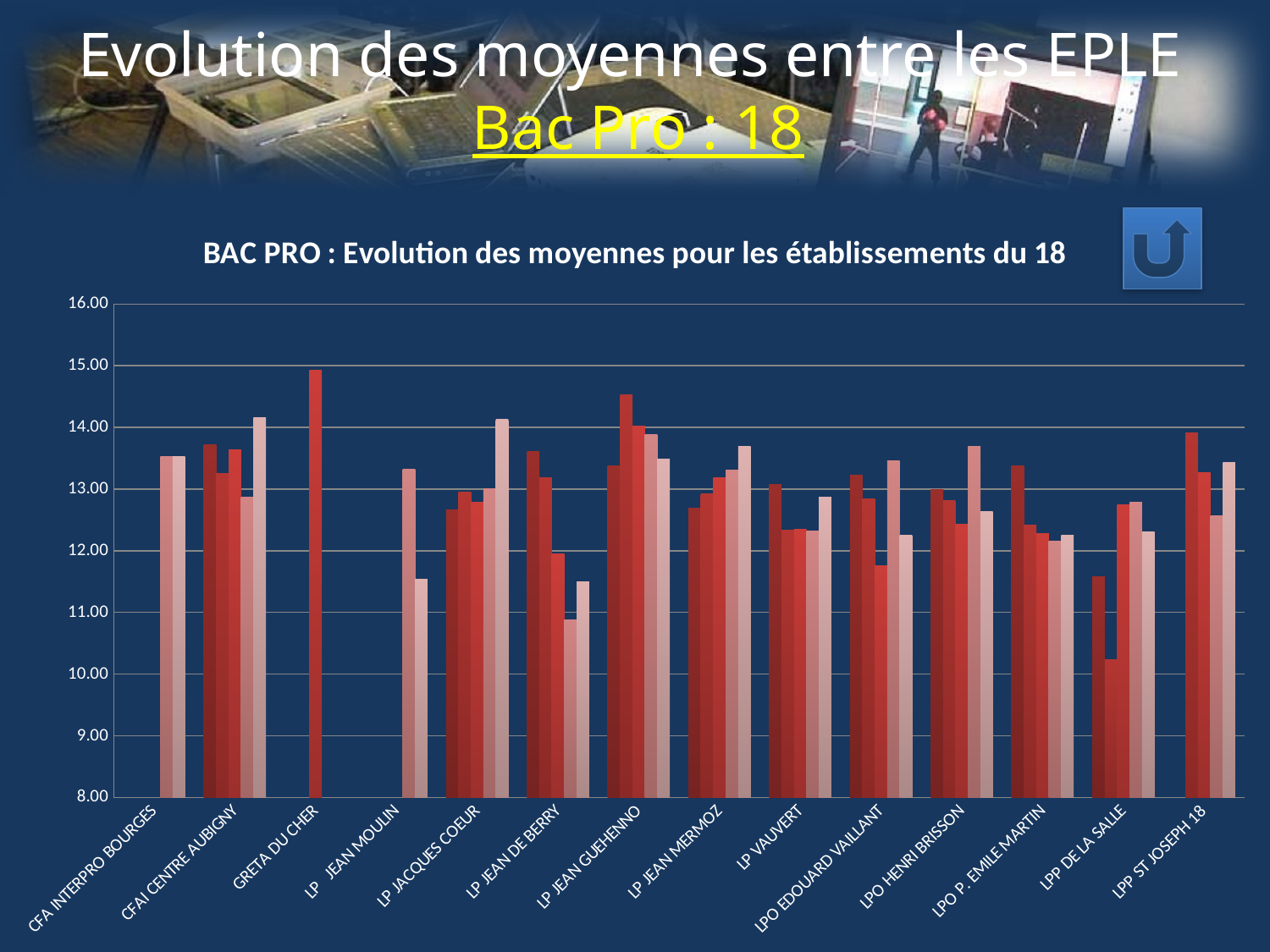
Is the value of the tallest bar for LP JEAN GUEHENNO greater or less than 14.00? greater How many establishments (categories) are shown on the x axis of the chart? 14 Which is taller: the bar for GRETA DU CHER or the tallest bar for LP JEAN GUEHENNO? GRETA DU CHER Is the value of the shortest bar for LP JEAN MOULIN greater or less than 12.00? less Are the bars for CFA INTERPRO BOURGES greater or less than 13.00? greater What is the title of the chart? BAC PRO : Evolution des moyennes pour les établissements du 18 Which establishment has the single tallest bar in the chart? GRETA DU CHER Which establishment has the single shortest bar in the chart? LPP DE LA SALLE What kind of chart is shown on the slide? bar chart What is the lowest value shown on the vertical axis of the chart? 8.00